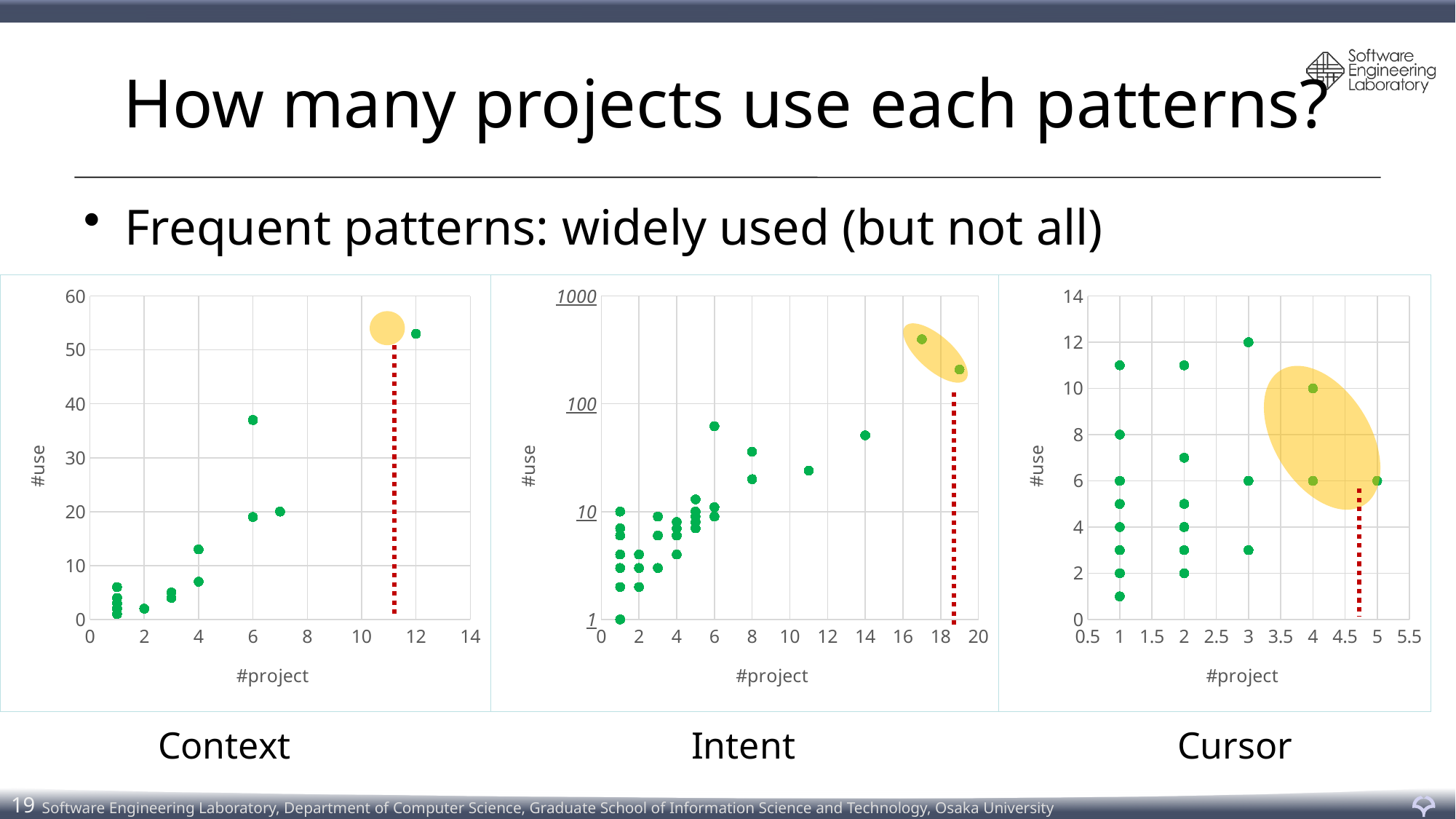
What kind of chart is the Context chart? scatter chart In the Context chart, is the #use value of the highest point greater or less than 50? greater In the Cursor chart, what is the #use value of the point at #project 5? 6 How many charts are shown on the slide? 3 In the Cursor chart, what is the lowest #use value plotted? 1 What is the label on the y axis of the Cursor chart? #use In the Intent chart, what is the lowest #use value plotted? 1 In the Intent chart, is the largest #project value greater or less than 16? greater In the Cursor chart, what is the highest #use value plotted? 12 What is the label on the x axis of the Intent chart? #project In the Context chart, what is the largest #project value among the plotted points? 12